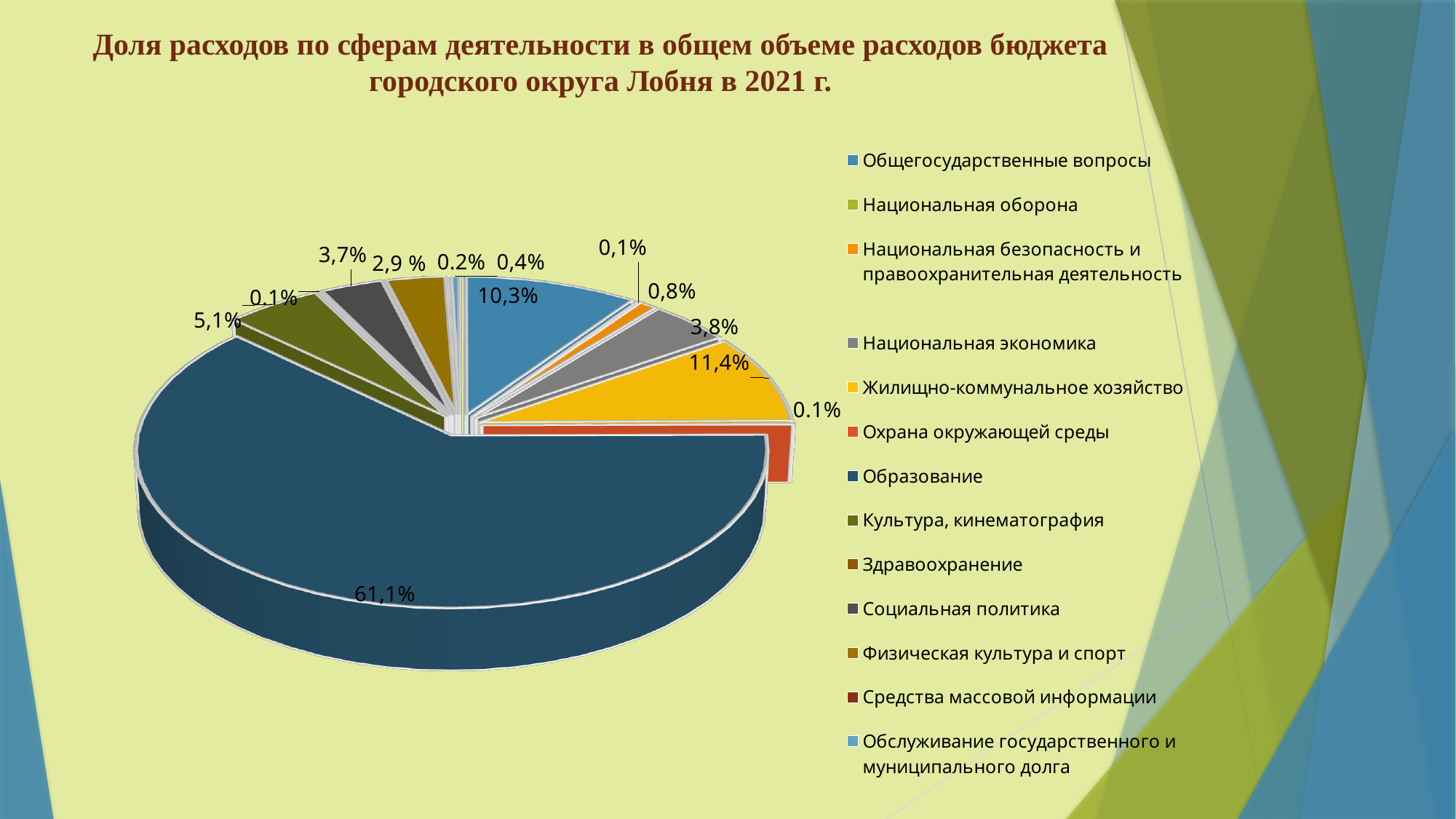
What is the difference between the share for Общегосударственные вопросы and the share for Культура, кинематография? 5,2% What is the difference between the share for Образование and the share for Жилищно-коммунальное хозяйство? 49,7% What share of budget expenditure does Национальная экономика account for? 3,8% What share of budget expenditure does Жилищно-коммунальное хозяйство account for? 11,4% Which category has the largest share of budget expenditure? Образование What share of budget expenditure does Образование account for? 61,1% What kind of chart is shown on the slide? pie chart What share of budget expenditure does Культура, кинематография account for? 5,1% What share of budget expenditure does Общегосударственные вопросы account for? 10,3% What year does the chart title say the budget expenditure shares refer to? 2021 Which is larger: the share for Жилищно-коммунальное хозяйство or the share for Общегосударственные вопросы? Жилищно-коммунальное хозяйство How many categories does the legend of the pie chart list? 13